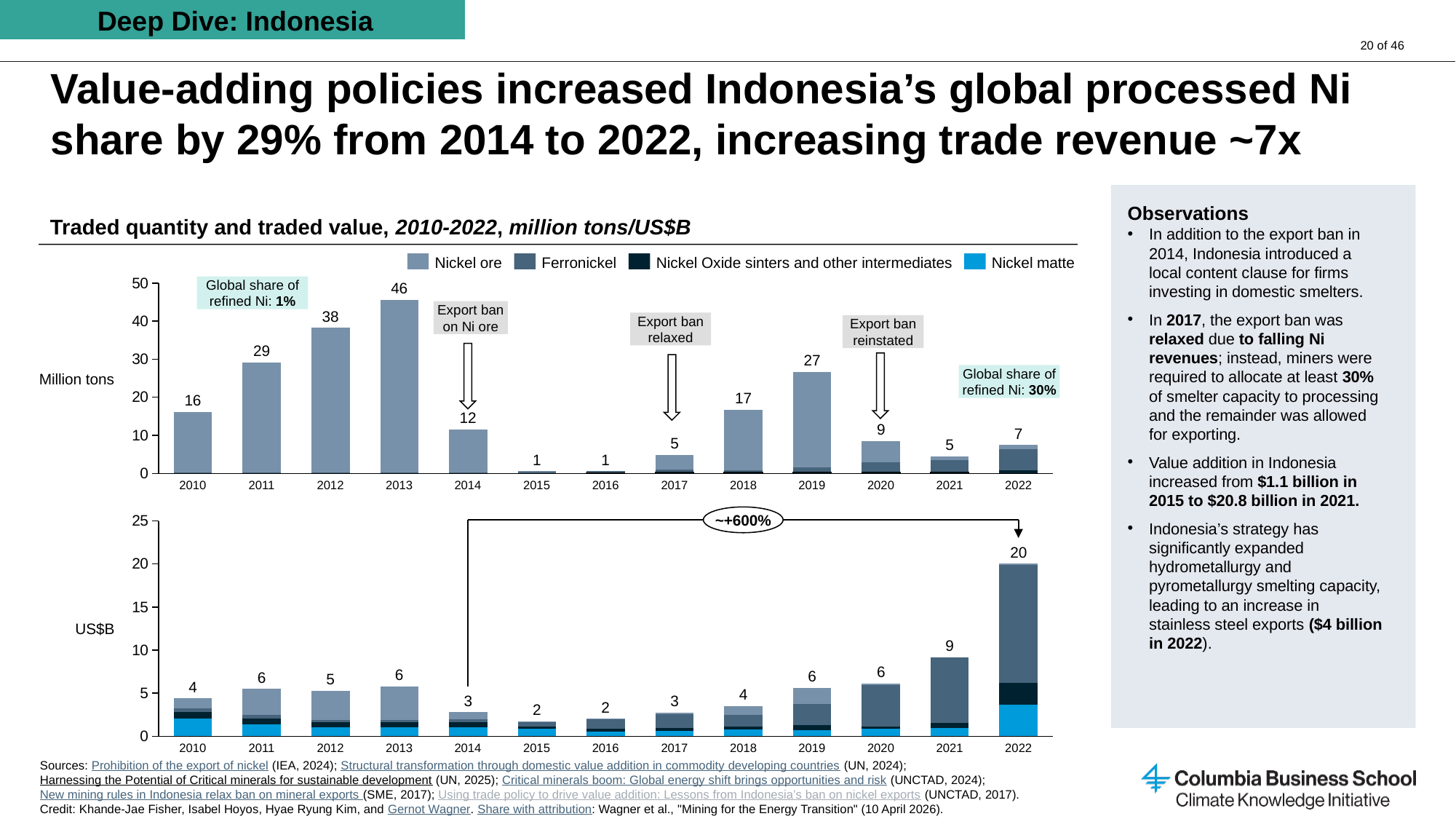
In the top chart (Million tons), which year has the highest total traded quantity? 2013 In the top chart (Million tons), do the totals rise or fall from 2010 to 2013? Rise In the bottom chart (US$B), what is the total traded value labelled for 2022? 20 How many series does the legend list for the charts? 4 In the bottom chart (US$B), what is the difference between the 2022 total and the 2021 total? 11 What kind of chart is the bottom chart (US$B)? Stacked bar chart How many years are shown on the x axis of the top chart (Million tons)? 13 In the top chart (Million tons), what is the difference between the 2013 total and the 2014 total? 34 In the bottom chart (US$B), is the total for 2021 greater or less than 10? less In the top chart (Million tons), what is the total traded quantity labelled for 2013? 46 In the bottom chart (US$B), which year has the highest total traded value? 2022 In the top chart (Million tons), which year has the larger total: 2018 or 2019? 2019